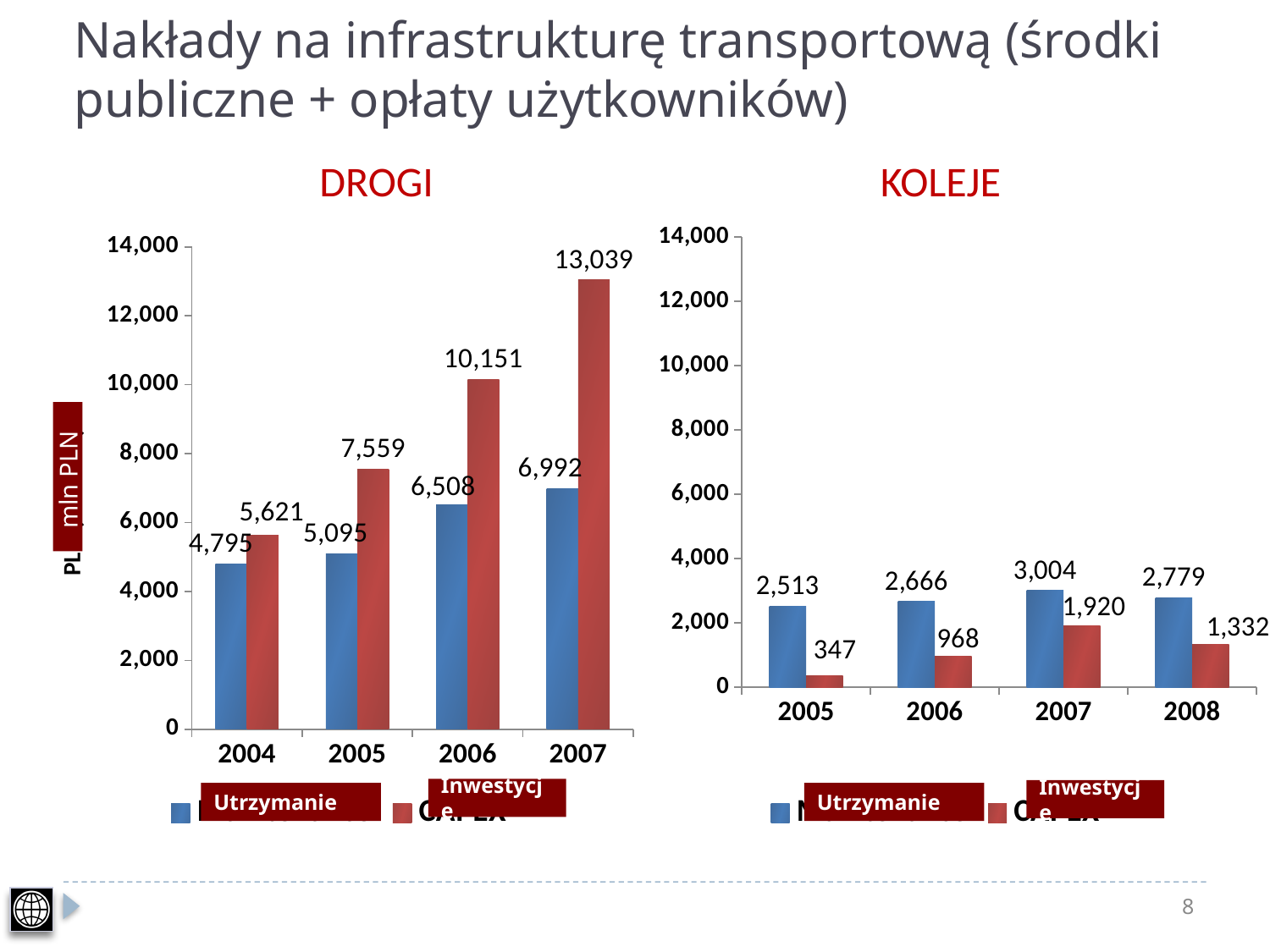
In the DROGI chart, how many years are shown on the x axis? 4 In the KOLEJE chart, what is the difference between the Inwestycje values for 2007 and 2006? 952 In the DROGI chart, what is the value of the blue Utrzymanie bar for 2004? 4,795 In the DROGI chart, what is the value of the red Inwestycje bar for 2007? 13,039 In the DROGI chart, do the red Inwestycje values rise or fall from 2004 to 2007? Rise In the KOLEJE chart, what is the value of the blue Utrzymanie bar for 2008? 2,779 In the KOLEJE chart, which year has the highest blue Utrzymanie value? 2007 In the DROGI chart, which year has the lowest red Inwestycje value? 2004 In the DROGI chart, what is the difference between the Inwestycje and Utrzymanie values for 2006? 3,643 In the KOLEJE chart, which is larger for 2008: the Utrzymanie bar or the Inwestycje bar? Utrzymanie In the KOLEJE chart, what is the value of the red Inwestycje bar for 2005? 347 What type of chart is the KOLEJE chart? Bar chart